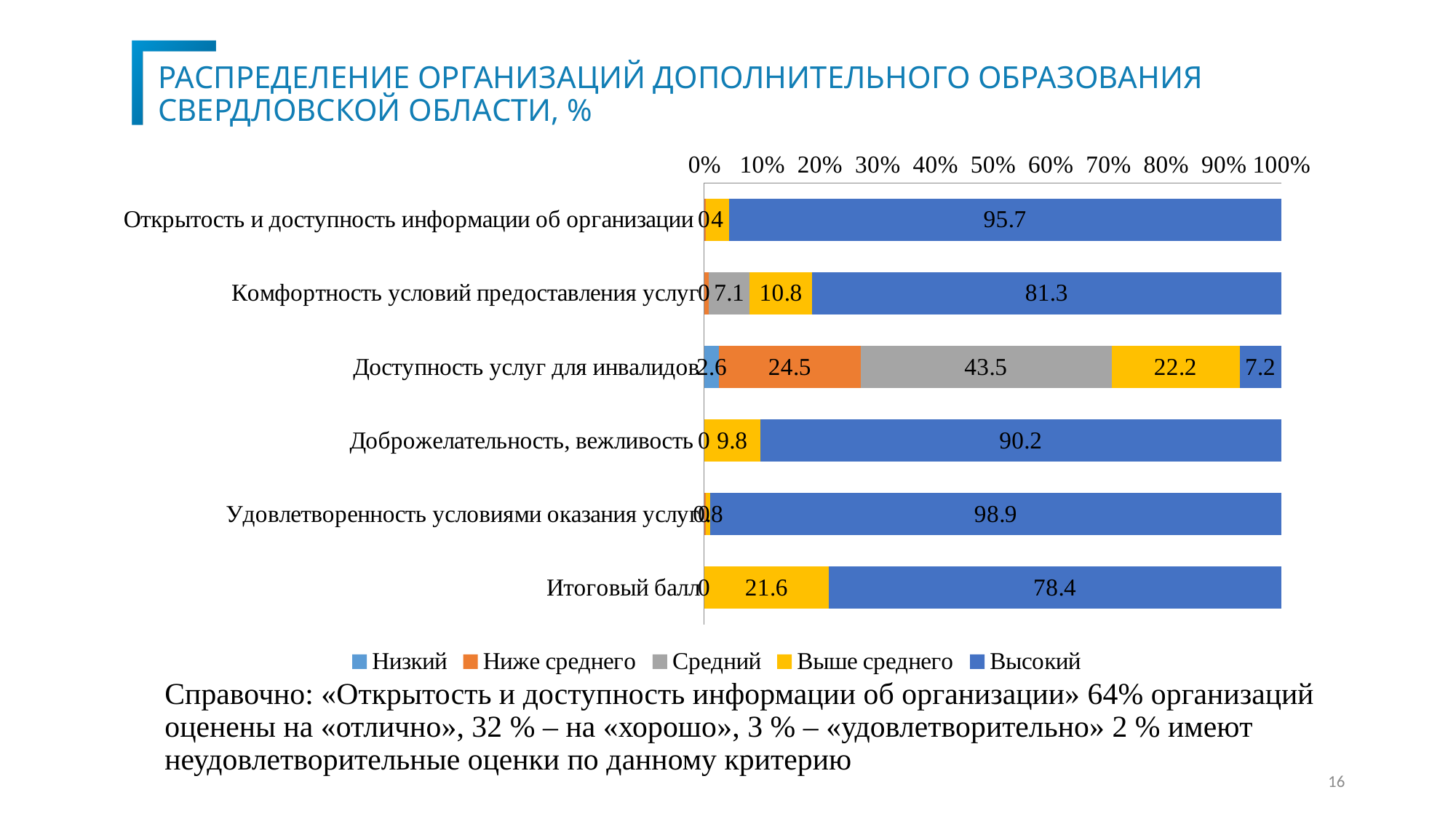
Which category has the lowest value in the «Высокий» series? Доступность услуг для инвалидов What is the value of the «Средний» series for «Доступность услуг для инвалидов»? 43.5 What is the value of the «Выше среднего» series for «Итоговый балл»? 21.6 How many categories are plotted on the chart? 6 What is the value of the «Высокий» series for «Доступность услуг для инвалидов»? 7.2 What is the difference between the «Высокий» values for «Доброжелательность, вежливость» and «Итоговый балл»? 11.8 What is the first entry in the chart legend? Низкий What kind of chart is shown on the slide? Stacked bar chart What is the value of the «Высокий» series for «Комфортность условий предоставления услуг»? 81.3 For «Доступность услуг для инвалидов», which is larger: the «Ниже среднего» value or the «Выше среднего» value? Ниже среднего Which category has the highest value in the «Высокий» series? Удовлетворенность условиями оказания услуг How many series does the legend list? 5